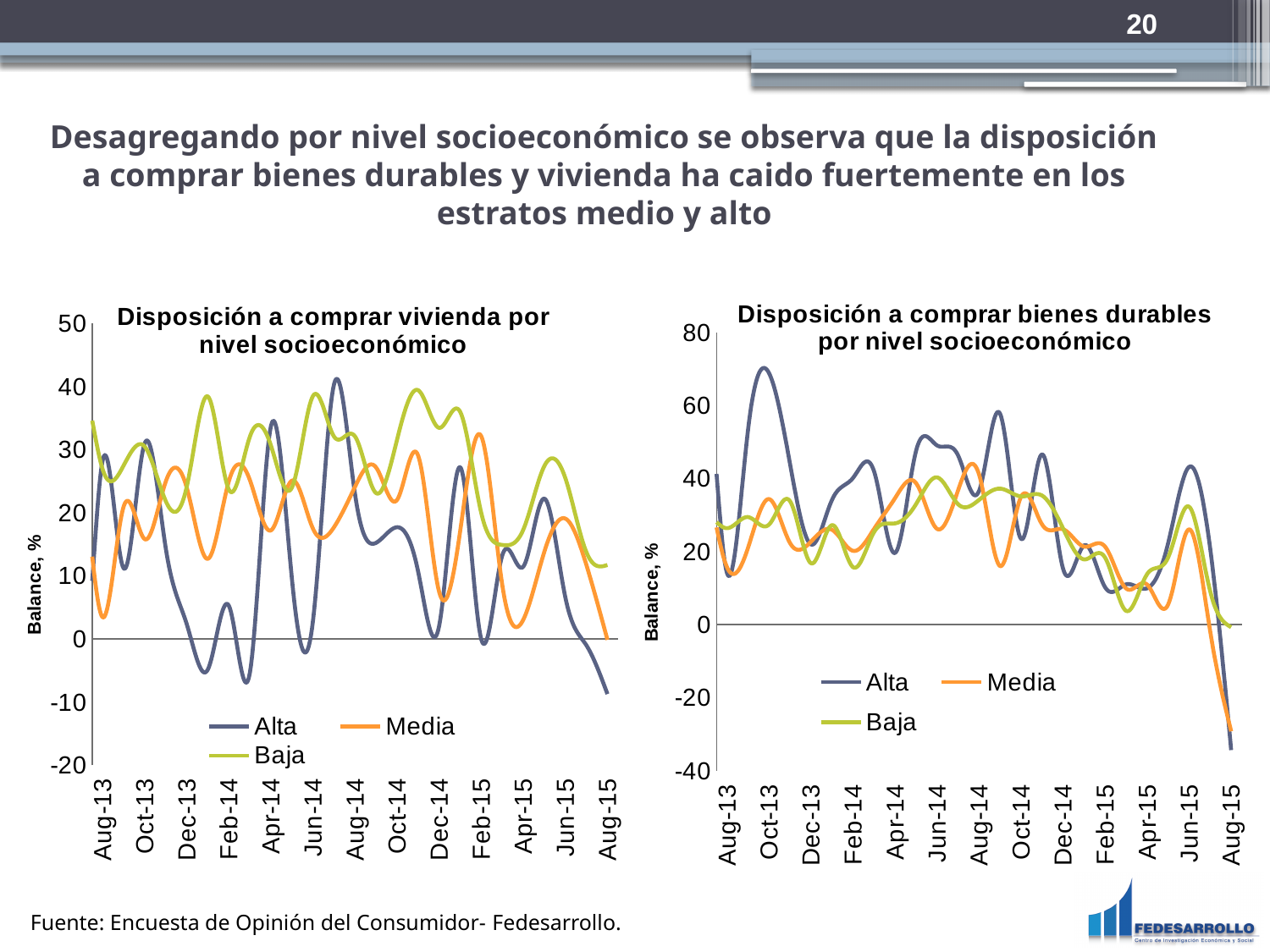
What kind of chart is the left chart, 'Disposición a comprar vivienda por nivel socioeconómico'? Line chart In the left chart, 'Disposición a comprar vivienda por nivel socioeconómico', is the value for Alta at Aug-15 greater or less than 0? less In the right chart, 'Disposición a comprar bienes durables por nivel socioeconómico', does the Alta series rise or fall between Jun-15 and Aug-15? Fall In the left chart, 'Disposición a comprar vivienda por nivel socioeconómico', is the value for Baja at Dec-13 greater or less than 30? less In the right chart, 'Disposición a comprar bienes durables por nivel socioeconómico', is the value for Alta at Aug-15 greater or less than -20? less How many series does the legend of the right chart, 'Disposición a comprar bienes durables por nivel socioeconómico', list? 3 In the left chart, 'Disposición a comprar vivienda por nivel socioeconómico', which is larger at Dec-13: Baja or Alta? Baja How many month labels are shown on the x axis of the left chart, 'Disposición a comprar vivienda por nivel socioeconómico'? 13 In the left chart, 'Disposición a comprar vivienda por nivel socioeconómico', what are the three series named in the legend? Alta, Media, Baja What is the y-axis label of the right chart, 'Disposición a comprar bienes durables por nivel socioeconómico'? Balance, % In the right chart, 'Disposición a comprar bienes durables por nivel socioeconómico', which is larger at Oct-13: Alta or Media? Alta